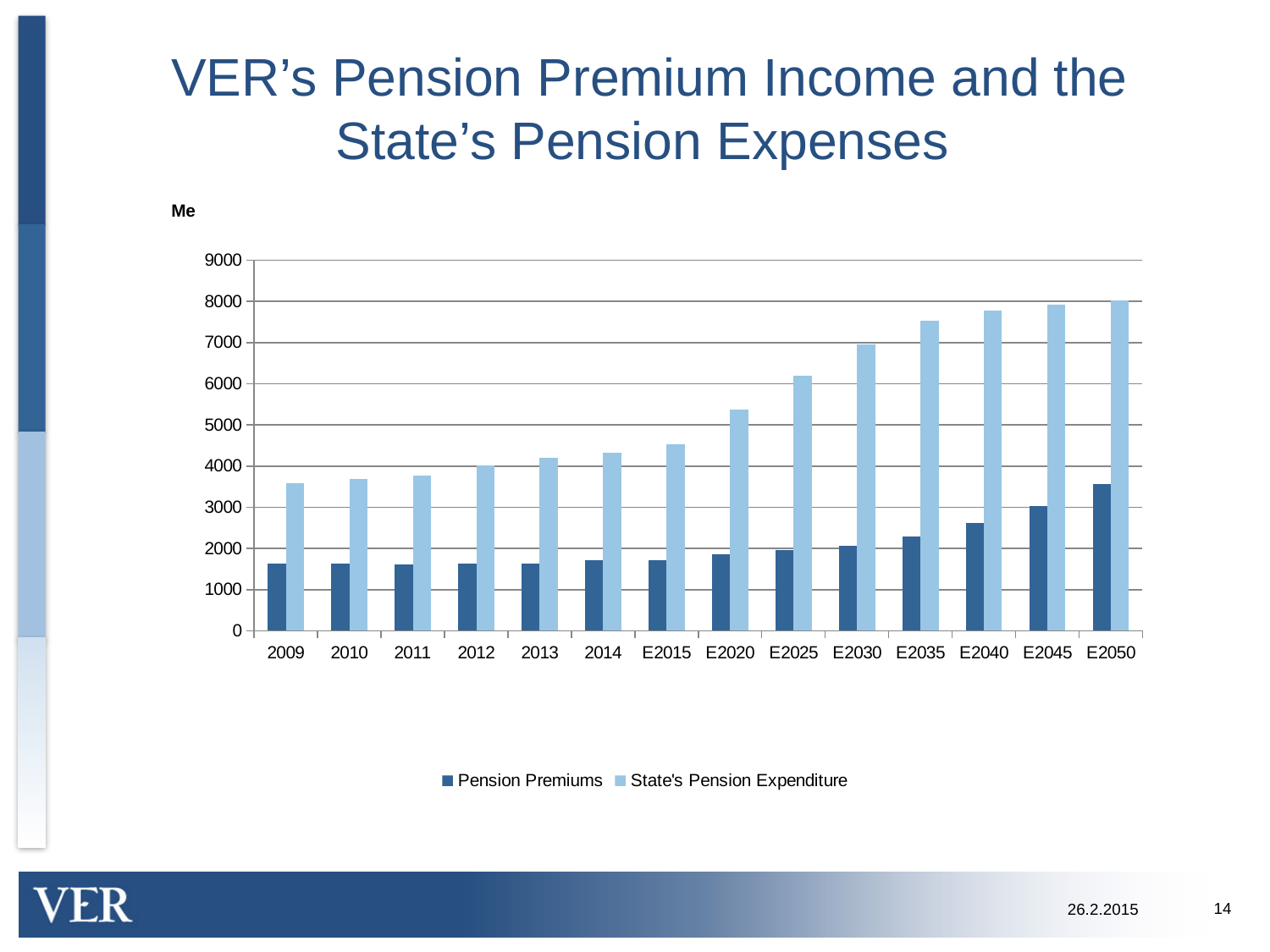
How many series does the legend list? 2 Does the State's Pension Expenditure rise or fall from 2009 to E2050? rise How many year categories are shown on the x axis? 14 Which year has the highest Pension Premiums value? E2050 In E2050, which is larger: Pension Premiums or State's Pension Expenditure? State's Pension Expenditure Which year has the highest State's Pension Expenditure? E2050 Which year has the lowest State's Pension Expenditure? 2009 What kind of chart is shown on the slide? bar chart Is the State's Pension Expenditure for 2009 greater or less than 4000? less Is the State's Pension Expenditure for E2035 greater or less than 7000? greater Is the Pension Premiums value for 2009 greater or less than 2000? less